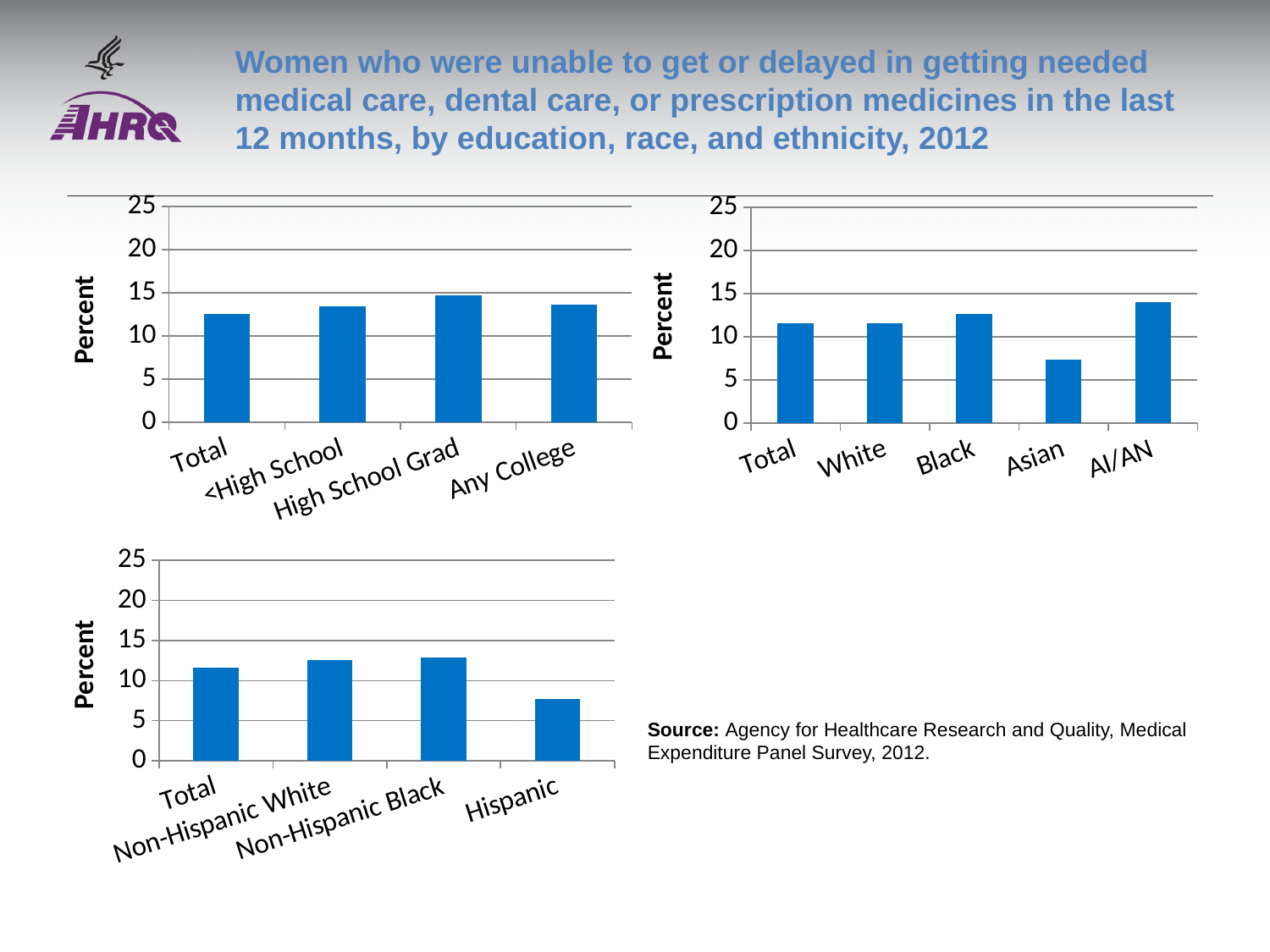
On the top-right chart (by race), which category has the lowest value? Asian How many categories are shown on the bottom-left chart (by ethnicity)? 4 What is the label on the vertical axis of the bottom-left chart (by ethnicity)? Percent On the top-right chart (by race), is the value for Asian greater or less than 10? less What kind of chart is the top-left chart (by education)? bar chart On the top-right chart (by race), which is larger, the value for Black or the value for Asian? Black On the bottom-left chart (by ethnicity), which category has the lowest value? Hispanic On the top-left chart (by education), which category has the highest value? High School Grad How many categories are shown on the top-right chart (by race)? 5 How many categories are shown on the top-left chart (by education)? 4 On the top-right chart (by race), which category has the highest value? AI/AN On the top-left chart (by education), is the value for Total greater or less than 10? greater